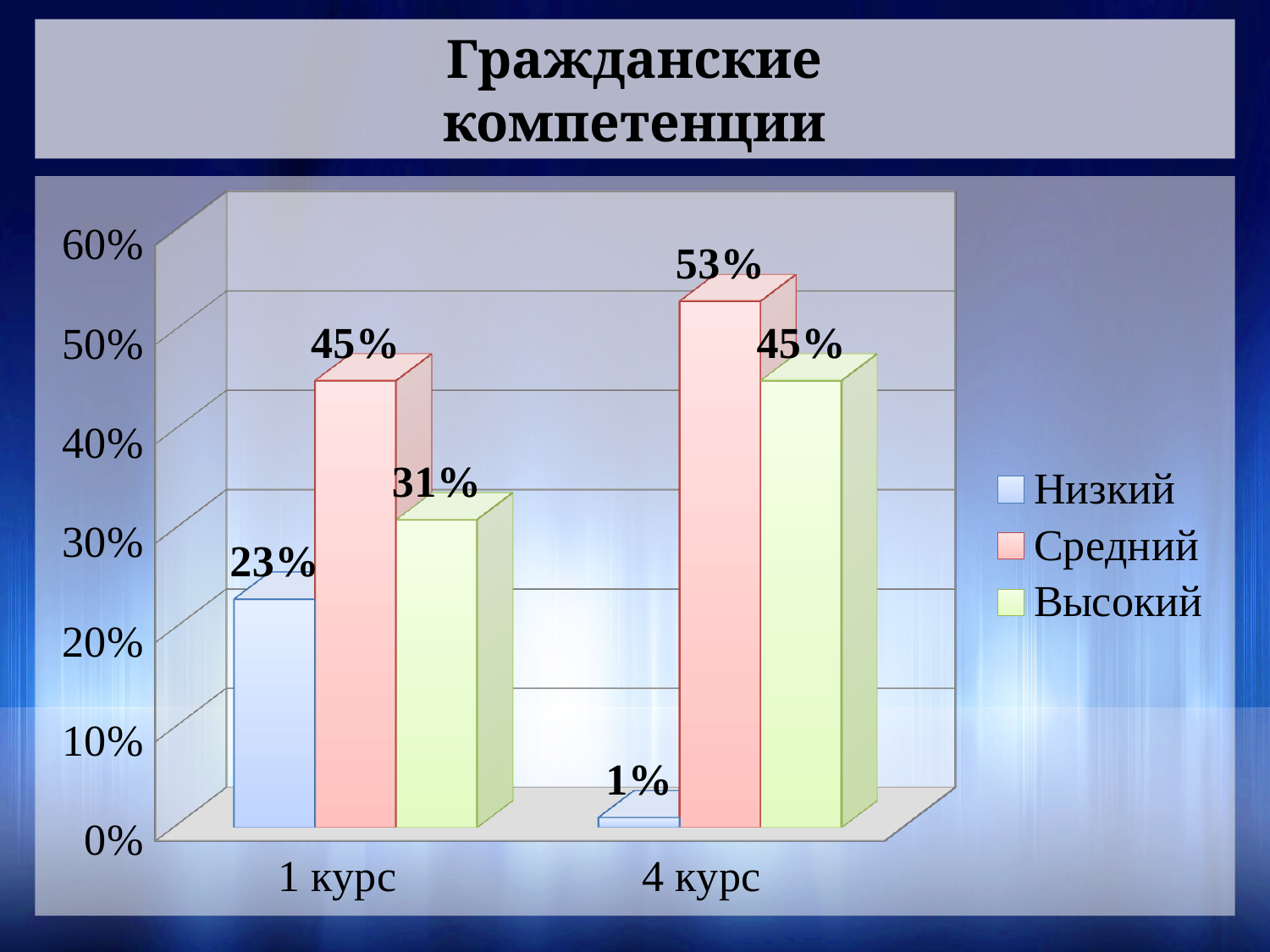
What is the value for Средний in 4 курс? 53% What is the value for Низкий in 4 курс? 1% How many categories are shown on the x axis? 2 What is the value for Низкий in 1 курс? 23% What is the value for Высокий in 1 курс? 31% What is the difference between the Средний values for 4 курс and 1 курс? 8% What is the title of the slide? Гражданские компетенции What kind of chart is shown on the slide? Bar chart Which series has the lowest value in 1 курс? Низкий How many series does the legend list? 3 Which series has the highest value in 4 курс? Средний Which is larger: Высокий in 1 курс or Высокий in 4 курс? Высокий in 4 курс